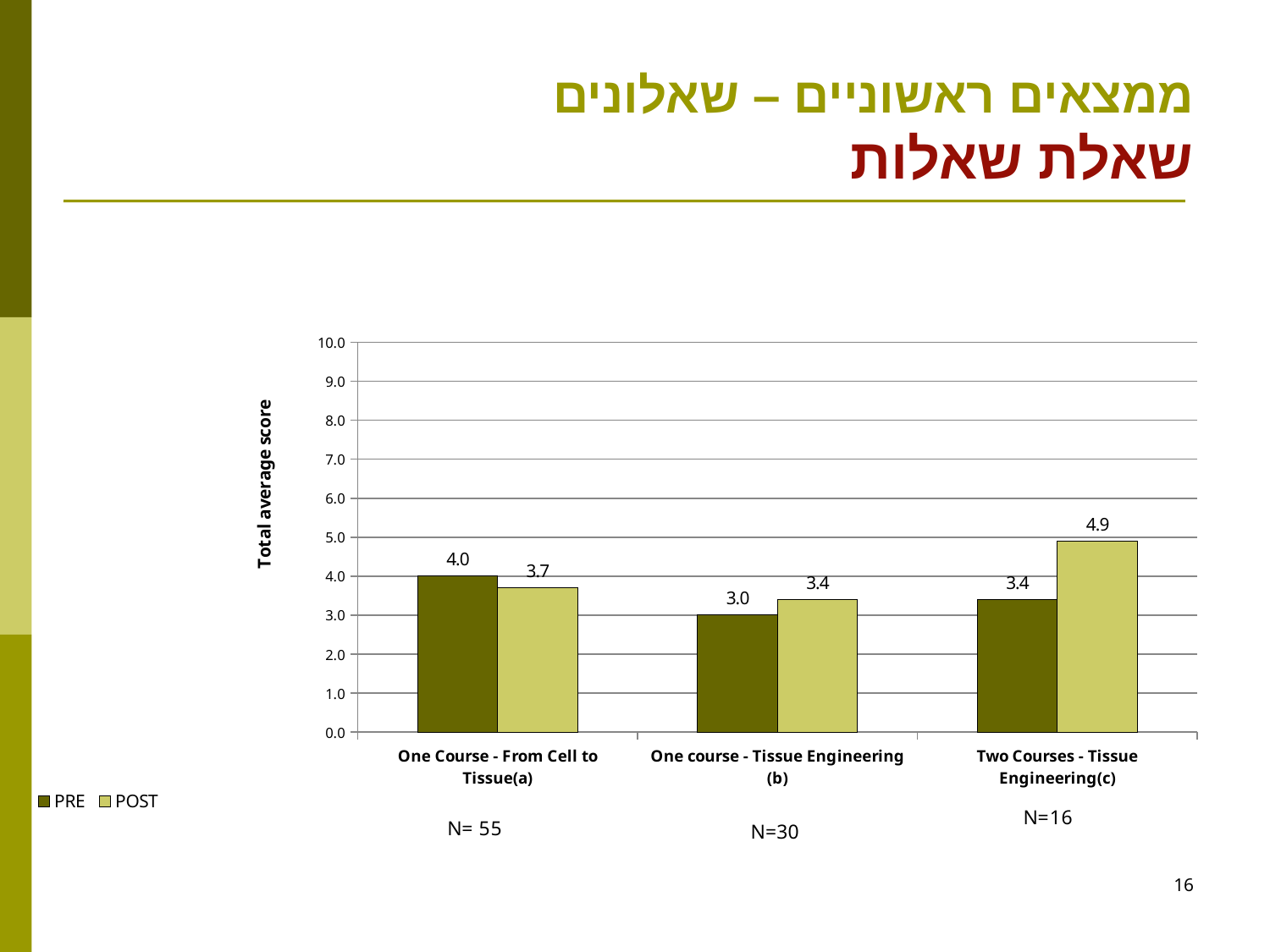
What is the POST value for Two Courses - Tissue Engineering(c)? 4.9 How many series does the legend list? 2 Which category has the highest POST value? Two Courses - Tissue Engineering(c) What is the PRE value for One Course - From Cell to Tissue(a)? 4.0 Which category has the lowest PRE value? One course - Tissue Engineering (b) How many categories are shown on the x axis? 3 Which is larger for One Course - From Cell to Tissue(a), the PRE value or the POST value? PRE What kind of chart is shown on the slide? Bar chart What is the POST value for One Course - From Cell to Tissue(a)? 3.7 What is the PRE value for One course - Tissue Engineering (b)? 3.0 What is the difference between the POST and PRE values for Two Courses - Tissue Engineering(c)? 1.5 What is the label of the y axis? Total average score